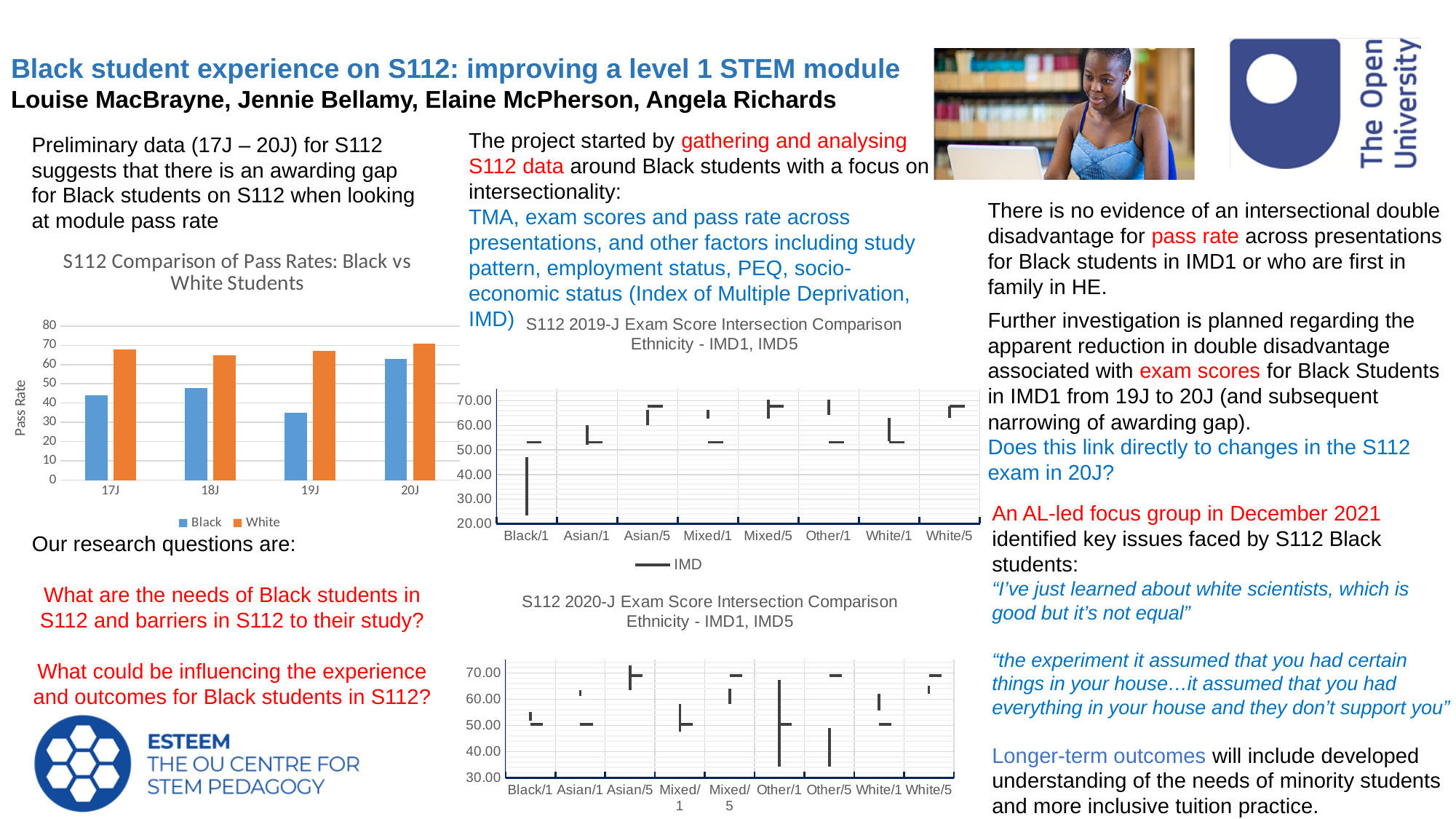
In the 'S112 2020-J Exam Score Intersection Comparison Ethnicity - IMD1, IMD5' chart, how many categories are shown on the x axis? 9 In the 'S112 Comparison of Pass Rates: Black vs White Students' chart, which is larger in 17J, the pass rate for Black students or for White students? White In the 'S112 Comparison of Pass Rates: Black vs White Students' chart, what is the label on the vertical axis? Pass Rate In the 'S112 Comparison of Pass Rates: Black vs White Students' chart, how many presentations are shown on the x axis? 4 In the 'S112 Comparison of Pass Rates: Black vs White Students' chart, which presentation has the highest pass rate for Black students? 20J In the 'S112 2019-J Exam Score Intersection Comparison Ethnicity - IMD1, IMD5' chart, what entry does the legend list? IMD In the 'S112 Comparison of Pass Rates: Black vs White Students' chart, is the pass rate for Black students in 19J greater or less than 40? less What kind of chart is 'S112 Comparison of Pass Rates: Black vs White Students'? Bar chart In the 'S112 Comparison of Pass Rates: Black vs White Students' chart, how many series does the legend list? 2 In the 'S112 2019-J Exam Score Intersection Comparison Ethnicity - IMD1, IMD5' chart, how many categories are shown on the x axis? 8 In the 'S112 Comparison of Pass Rates: Black vs White Students' chart, which presentation has the lowest pass rate for Black students? 19J